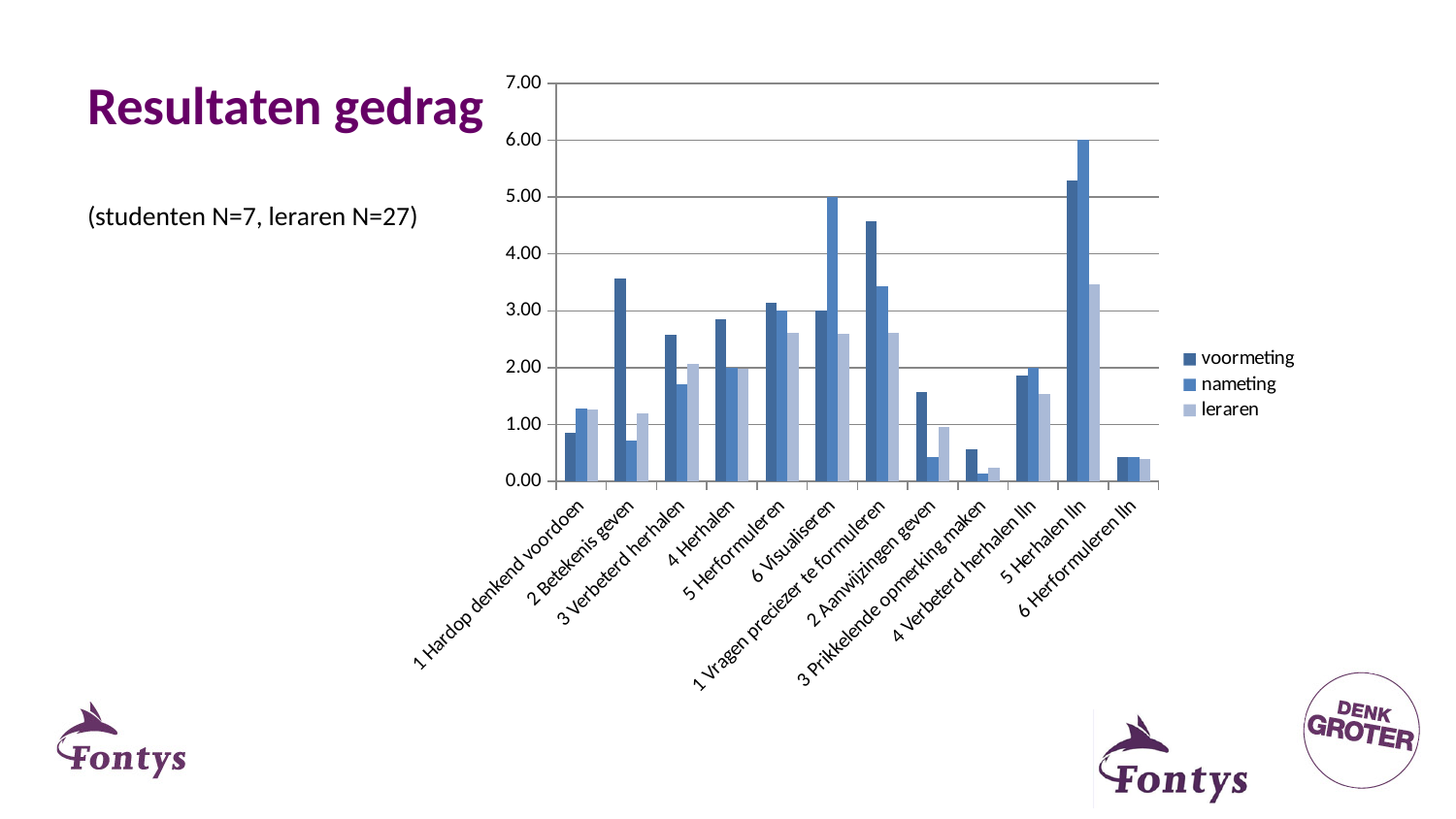
Which is larger for '1 Vragen preciezer te formuleren', voormeting or nameting? voormeting For which category is the voormeting bar the highest? 5 Herhalen lln What are the three series listed in the legend? voormeting, nameting, leraren How many categories are shown on the x axis? 12 Is the voormeting value for '2 Betekenis geven' greater or less than 3.00? greater Is the nameting value for '6 Visualiseren' greater or less than 4.00? greater Is the leraren value for '5 Herhalen lln' greater or less than 3.00? greater Which is larger for '2 Betekenis geven', voormeting or nameting? voormeting Which series has the highest bar for '5 Herhalen lln'? nameting How many series does the legend list? 3 What kind of chart is shown on the slide? bar chart